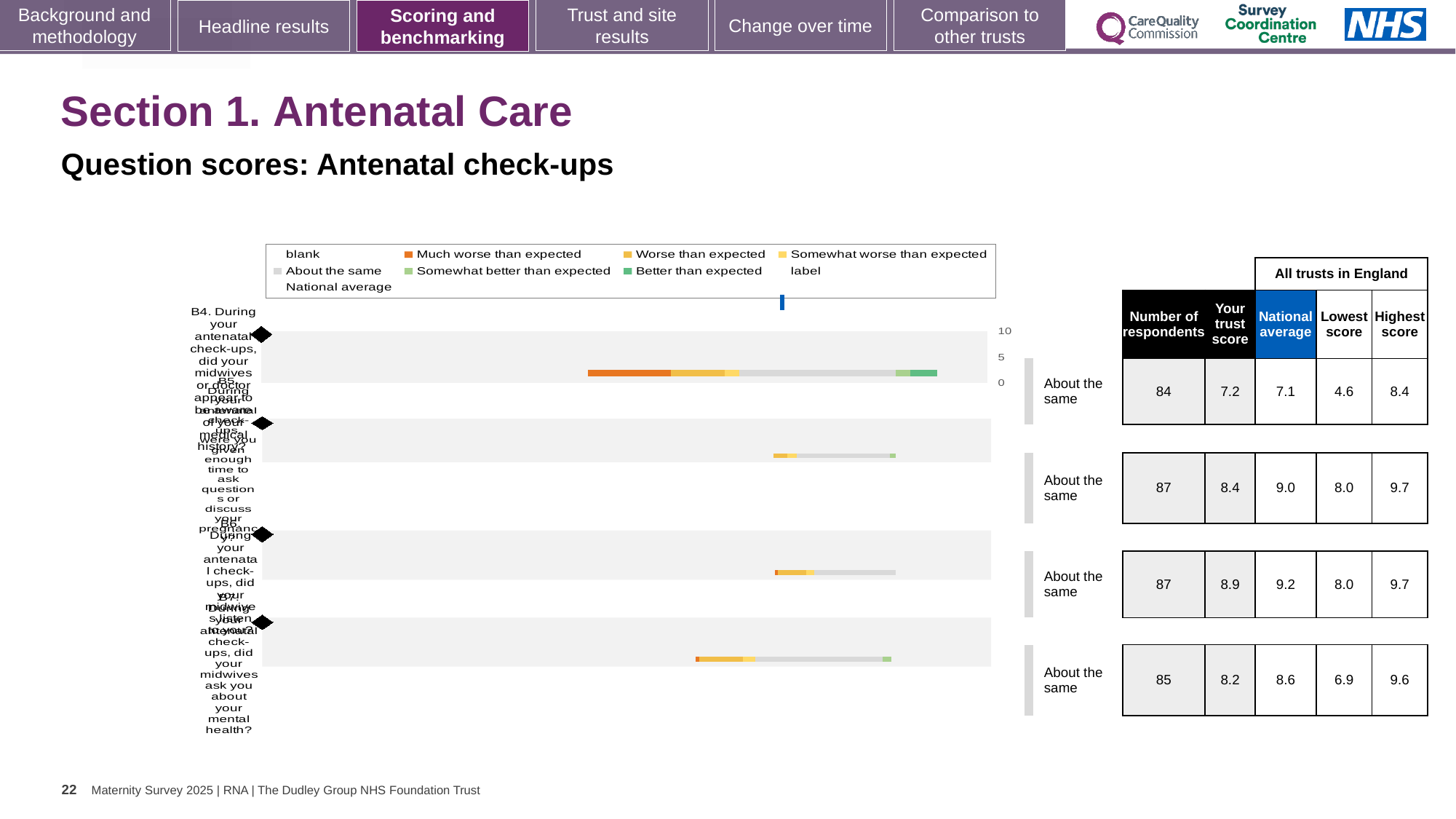
Which row has the lowest 'Your trust score'? first row (B4), 7.2 For the second row (B5), what is the difference between the national average and the trust score? 0.6 What is the 'Your trust score' value for the first row (B4)? 7.2 How many question rows (B4 to B7) are plotted in the chart? 4 For the first row (B4), which is larger: the trust score or the national average? trust score (7.2) What is the highest score among all trusts in England for the fourth row (B7)? 9.6 What colour represents 'Much worse than expected' in the chart legend? orange What comparison label is shown next to each of the four chart rows? About the same What kind of chart is shown on the slide? bar chart Which row has the highest 'Your trust score'? third row (B6), 8.9 What is the national average for the second row (B5)? 9.0 In the table beside the chart, what is the number of respondents for the first row (B4)? 84